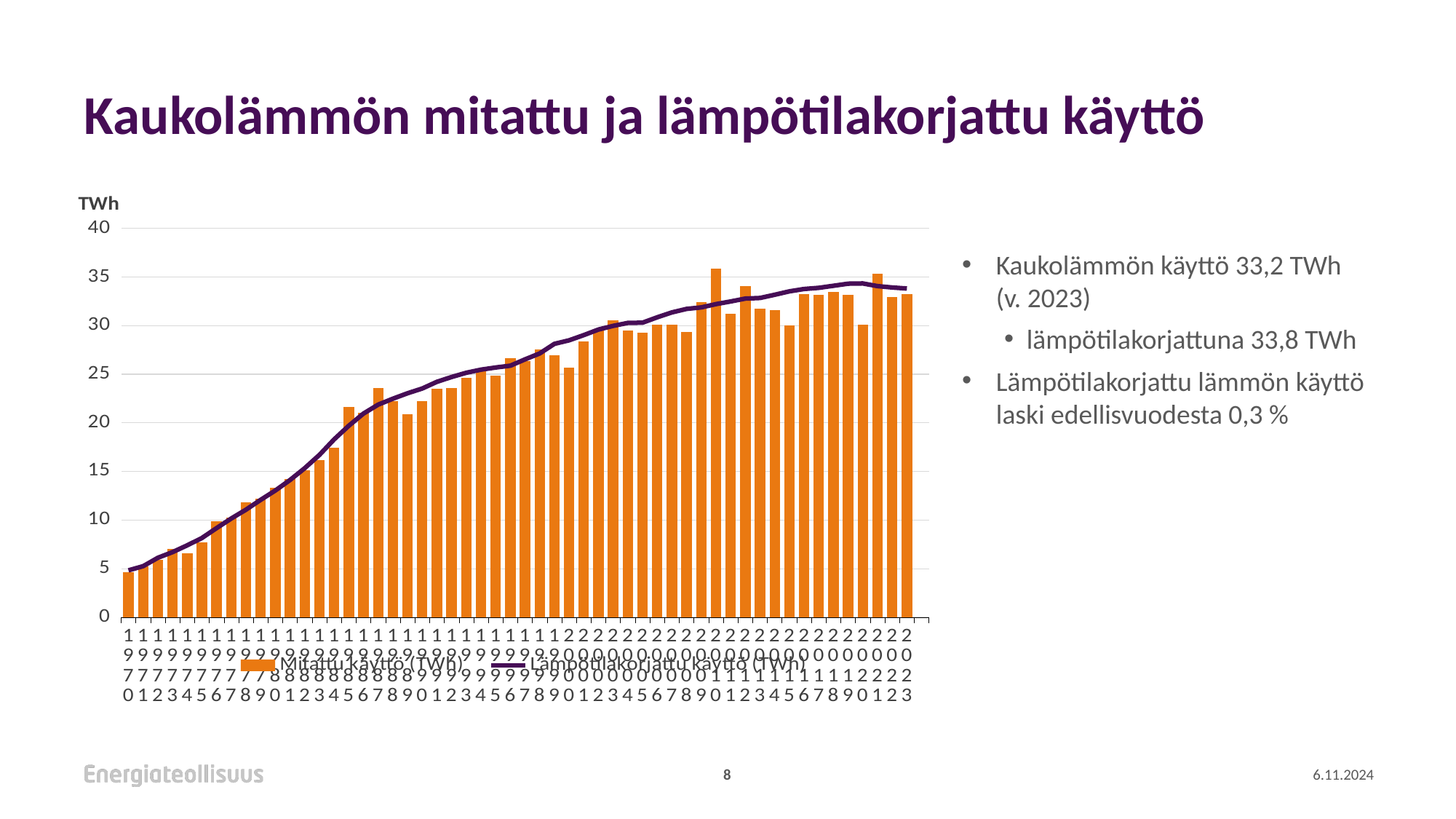
How many years (bars) are plotted in the chart? 54 What kind of chart is shown on the slide? Bar chart with a line Is the value for Mitattu käyttö in 2000 greater or less than 25? greater According to the slide, what was the district heating use (Kaukolämmön käyttö) in 2023? 33,2 TWh Is the value for Mitattu käyttö in 1980 greater or less than 10? greater Is the value for Mitattu käyttö in 2020 greater or less than 35? less Which is larger, the Mitattu käyttö bar for 2010 or for 2020? 2010 What unit is shown on the vertical axis of the chart? TWh Which year has the highest bar for Mitattu käyttö (TWh)? 2010 Overall, do the values rise or fall from 1970 to 2023? Rise Which year has the lowest bar for Mitattu käyttö (TWh)? 1970 How many series does the legend list? 2